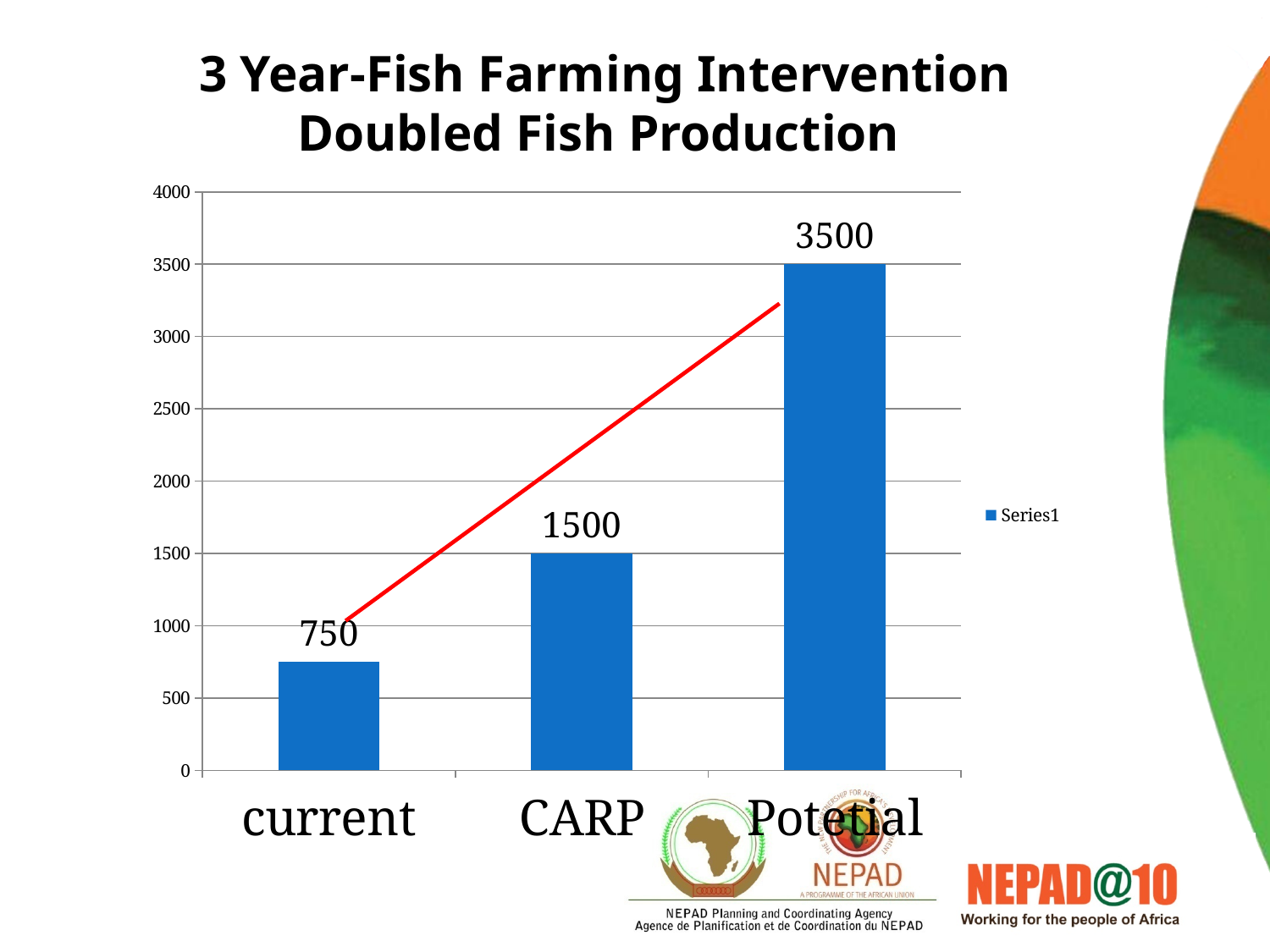
What is the value for current? 750 Do the values rise or fall from left to right along the x axis? rise What is the difference between the values for Potetial and CARP? 2000 How many series does the legend list? 1 What is the difference between the values for CARP and current? 750 What is the value for CARP? 1500 Which category has the lowest value? current What kind of chart is shown on the slide? bar chart What is the value for Potetial? 3500 Which is larger, the value for CARP or the value for current? CARP How many categories are shown on the x axis? 3 Which category has the highest value? Potetial